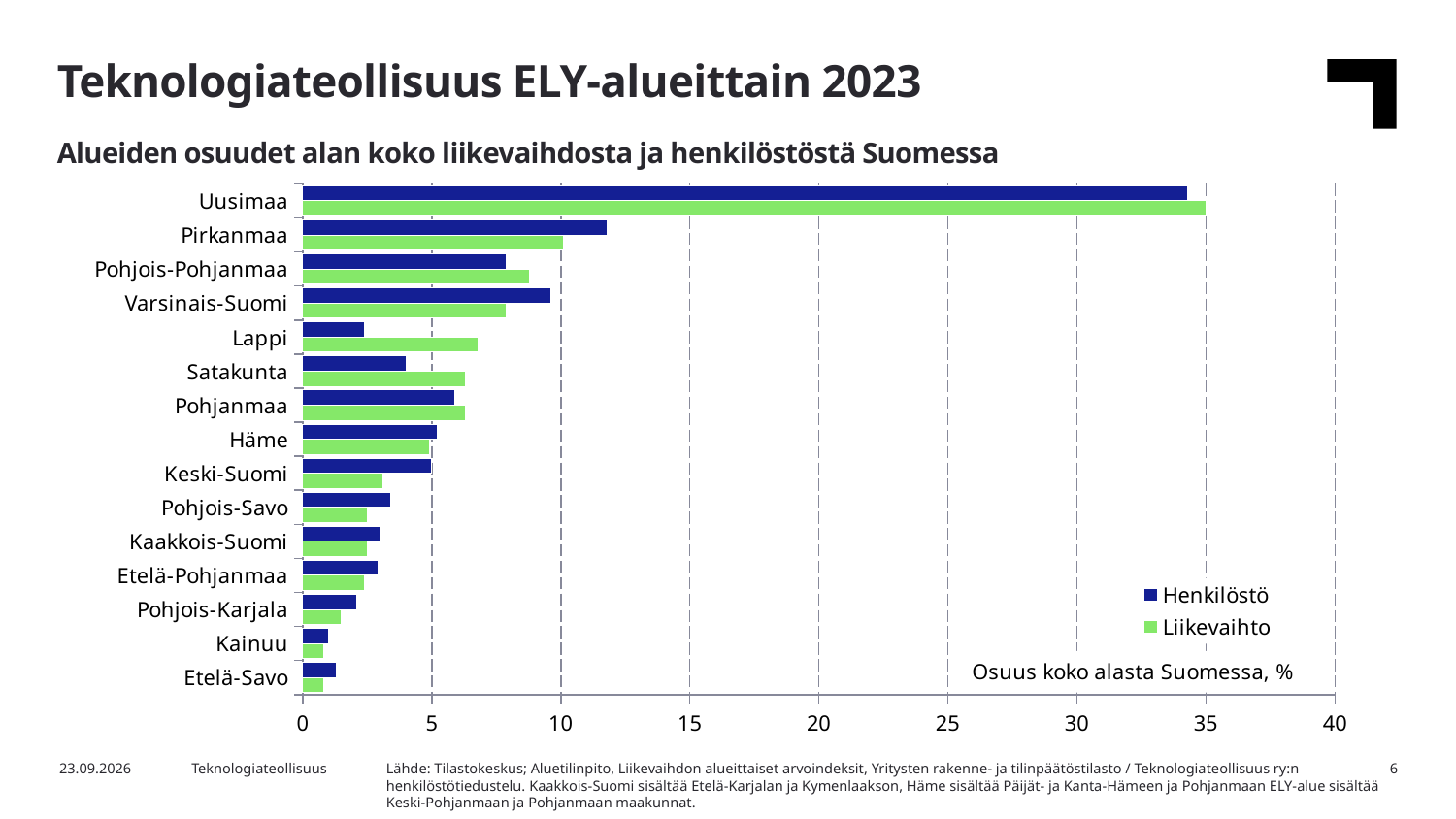
Is the Liikevaihto value for Uusimaa greater or less than 30? greater What is the label shown for the horizontal axis of the chart? Osuus koko alasta Suomessa, % How many series does the legend list? 2 For Lappi, which is larger: the Henkilöstö value or the Liikevaihto value? Liikevaihto What colour are the Henkilöstö bars? Blue Which has the larger Henkilöstö value: Varsinais-Suomi or Pohjois-Pohjanmaa? Varsinais-Suomi Is the Liikevaihto value for Satakunta greater or less than 5? greater Which region has the highest Henkilöstö value? Uusimaa How many regions (categories) are plotted on the chart? 15 What kind of chart is shown on the slide? Bar chart Is the Henkilöstö value for Pirkanmaa greater or less than 10? greater Which region has the highest Liikevaihto value? Uusimaa